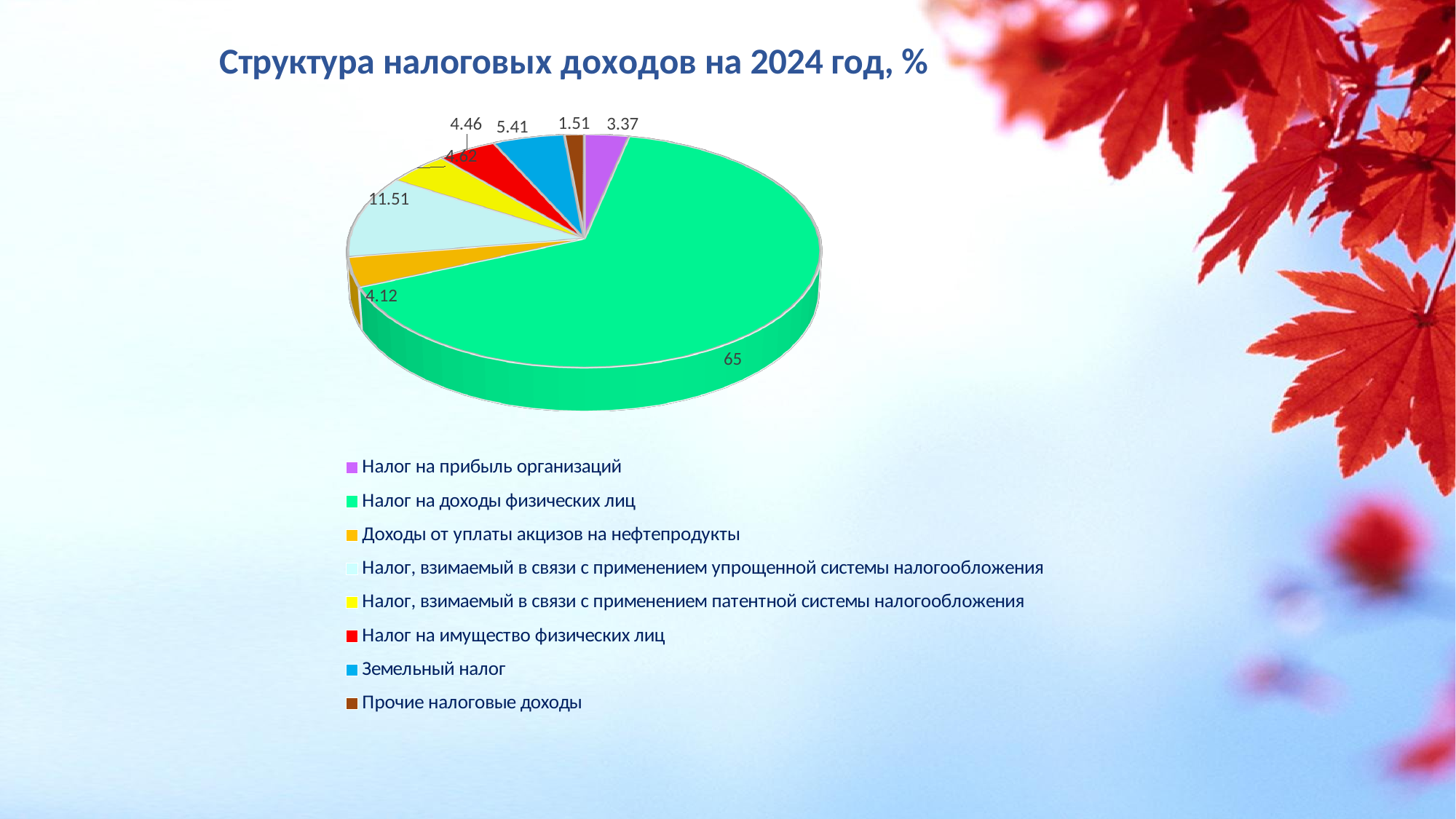
Which category has the smallest share of the pie? Прочие налоговые доходы What is the value for "Доходы от уплаты акцизов на нефтепродукты"? 4.12 What is the value for "Налог, взимаемый в связи с применением упрощенной системы налогообложения"? 11.51 How many categories does the legend of the pie chart list? 8 What is the title of the chart? Структура налоговых доходов на 2024 год, % What kind of chart is shown on the slide? pie chart What is the value for "Налог на доходы физических лиц"? 65 Which category has the largest share of the pie? Налог на доходы физических лиц What is the difference between the values for "Налог на доходы физических лиц" and "Налог, взимаемый в связи с применением упрощенной системы налогообложения"? 53.49 What is the value for "Налог на прибыль организаций"? 3.37 What is the value for "Земельный налог"? 5.41 What is the value for "Прочие налоговые доходы"? 1.51